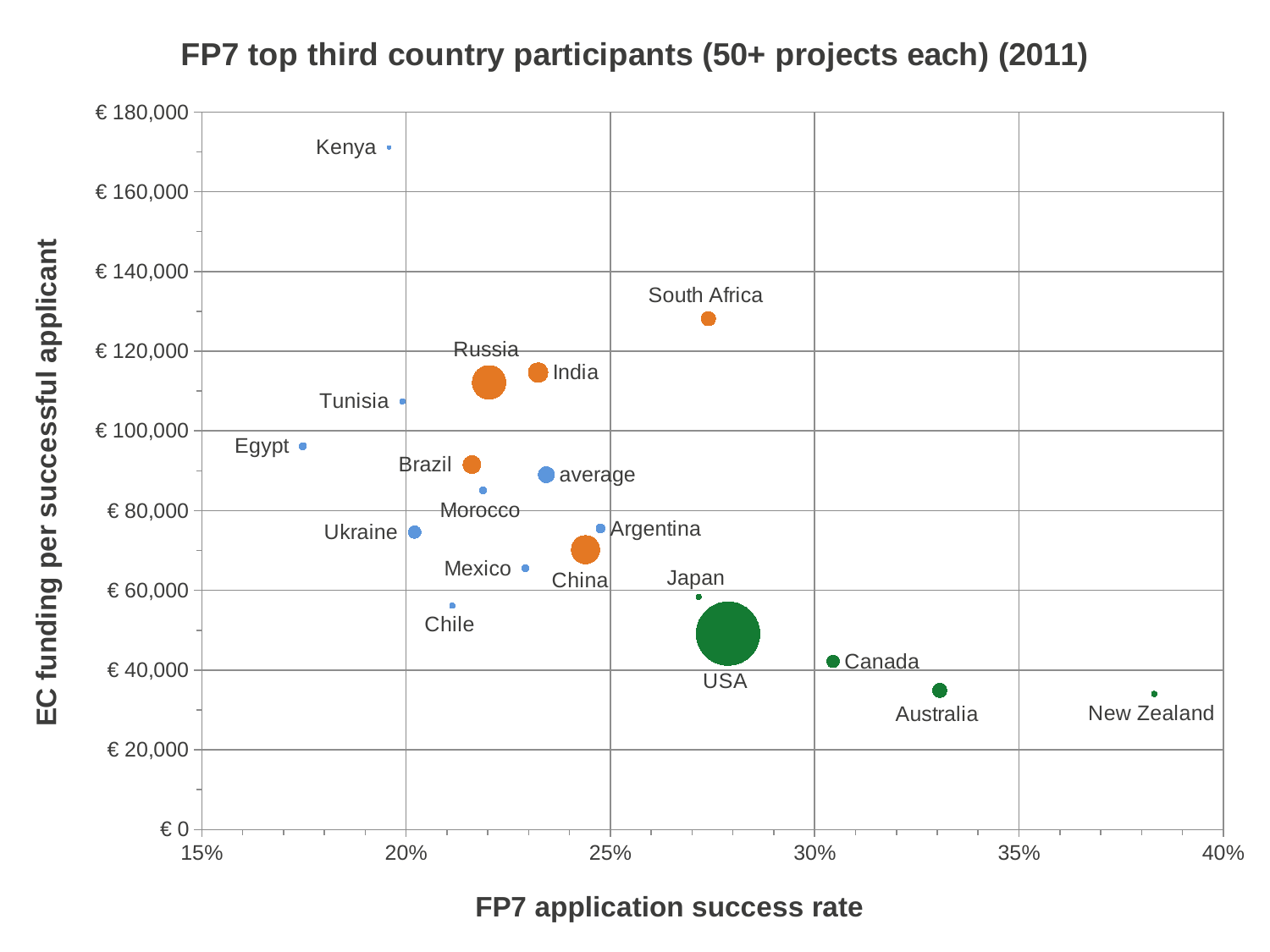
Which country has the highest EC funding per successful applicant? Kenya Which has the higher EC funding per successful applicant, South Africa or India? South Africa Is the EC funding per successful applicant for South Africa greater or less than € 120,000? greater Is the FP7 application success rate for Australia greater or less than 30%? greater Is the EC funding per successful applicant for Kenya greater or less than € 160,000? greater What kind of chart is shown on the slide? Bubble chart Which country has the highest FP7 application success rate? New Zealand What is the label of the vertical axis? EC funding per successful applicant How many labelled points are plotted on the chart? 19 What is the title of the chart? FP7 top third country participants (50+ projects each) (2011) Which country has the lowest FP7 application success rate? Egypt